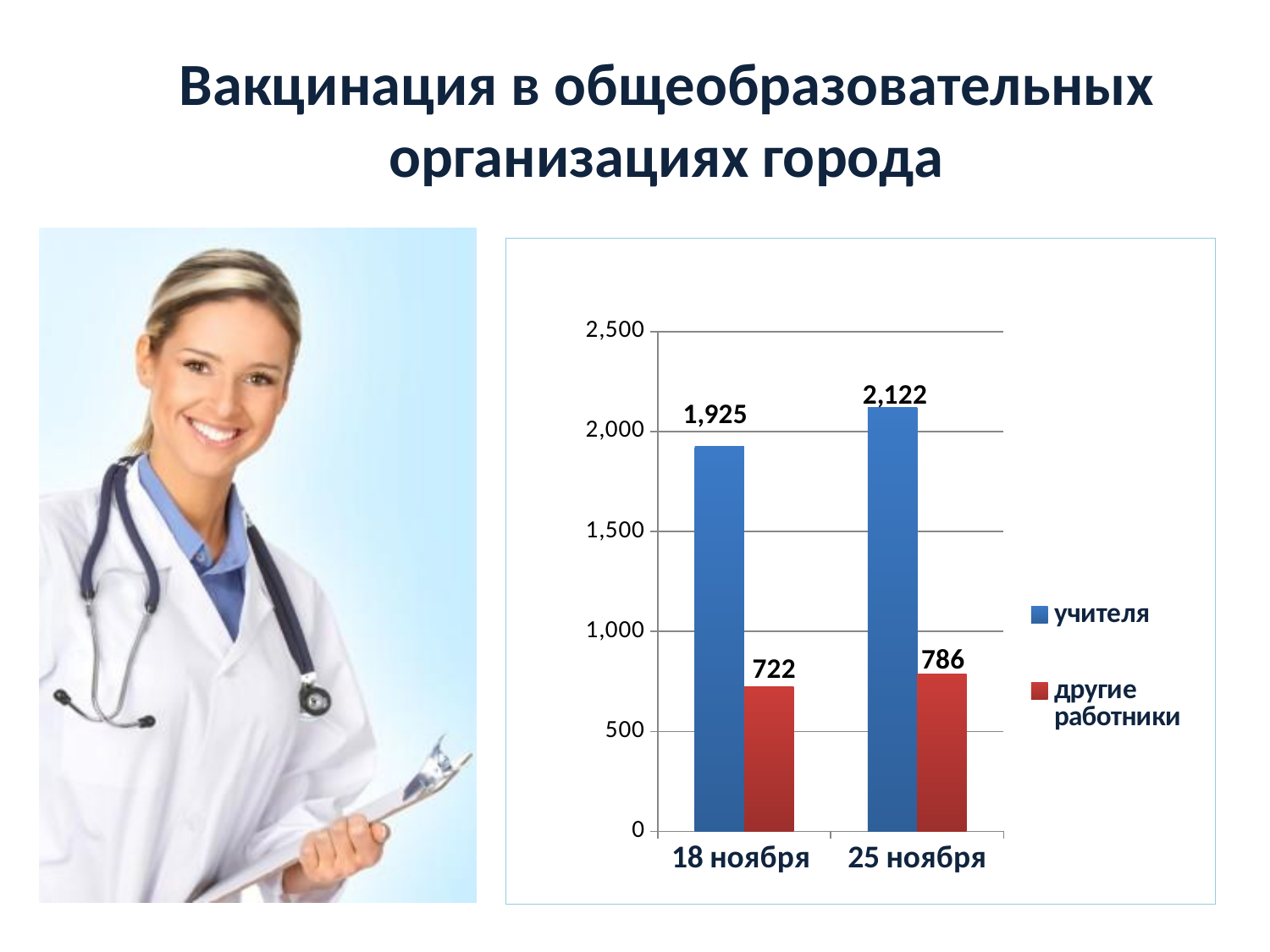
What is the value for учителя on 18 ноября? 1,925 What is the difference between the другие работники values on 25 ноября and 18 ноября? 64 What is the value for другие работники on 18 ноября? 722 What is the value for учителя on 25 ноября? 2,122 What is the value for другие работники on 25 ноября? 786 How many series does the legend list? 2 On which date is the value for учителя highest? 25 ноября Which is larger on 18 ноября: учителя or другие работники? учителя Do the values for учителя rise or fall from 18 ноября to 25 ноября? rise What kind of chart is shown on the slide? bar chart What is the difference between the учителя values on 25 ноября and 18 ноября? 197 On which date is the value for другие работники lowest? 18 ноября